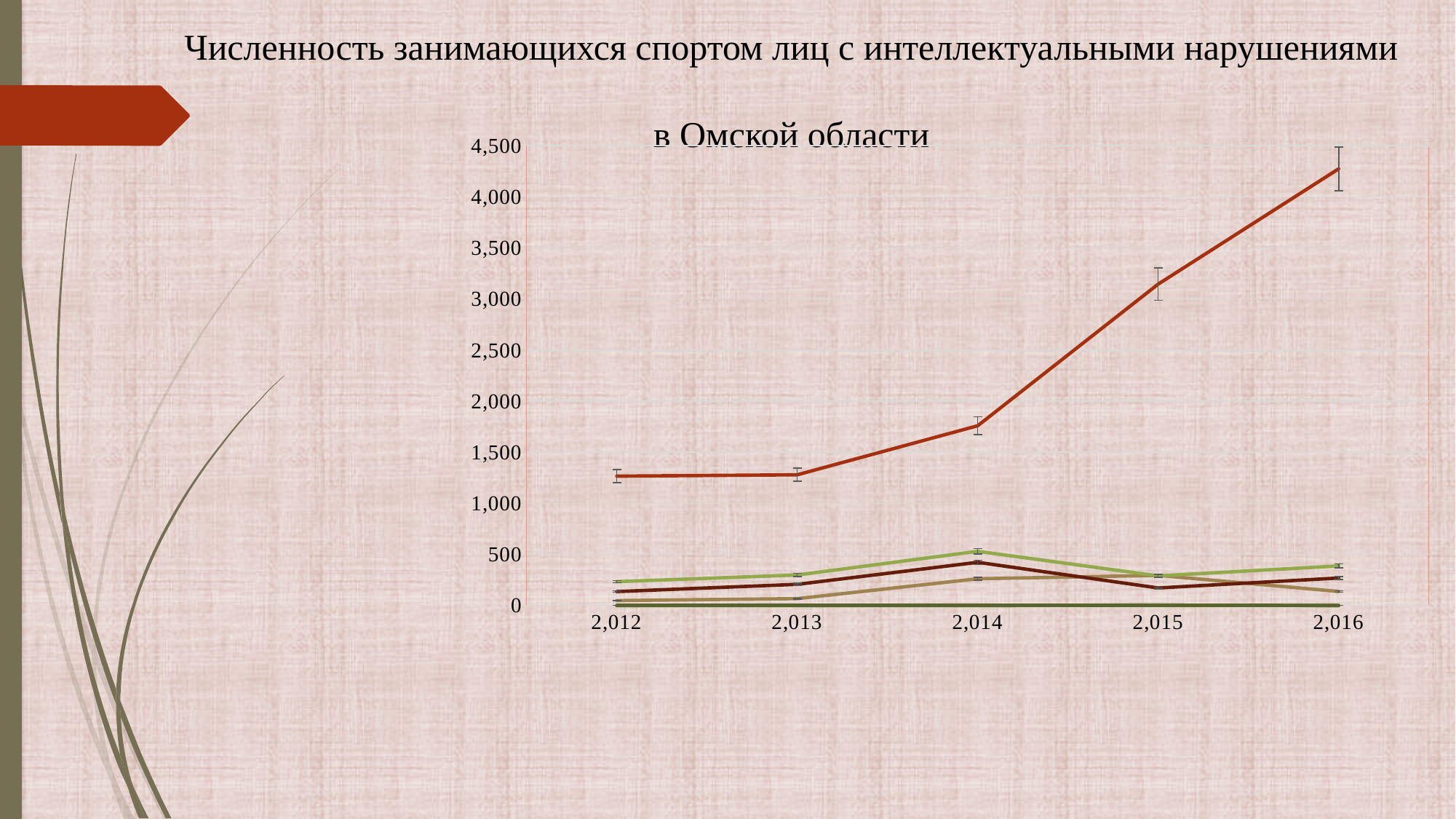
What is the first year shown on the x axis? 2,012 Does the red line rise or fall from 2,013 to 2,016? rise Is the value of the red line for 2,016 greater or less than 4,000? greater How many years are shown along the x axis of the chart? 5 What is the highest tick value shown on the y axis? 4,500 Is the value of the red line for 2,014 greater or less than 2,000? less Which is larger for the red line: the value for 2,016 or the value for 2,012? 2,016 What is the last year shown on the x axis? 2,016 Is the value of the red line for 2,012 greater or less than 1,500? less In which year does the red line reach its highest value? 2,016 What kind of chart is shown on the slide? line chart